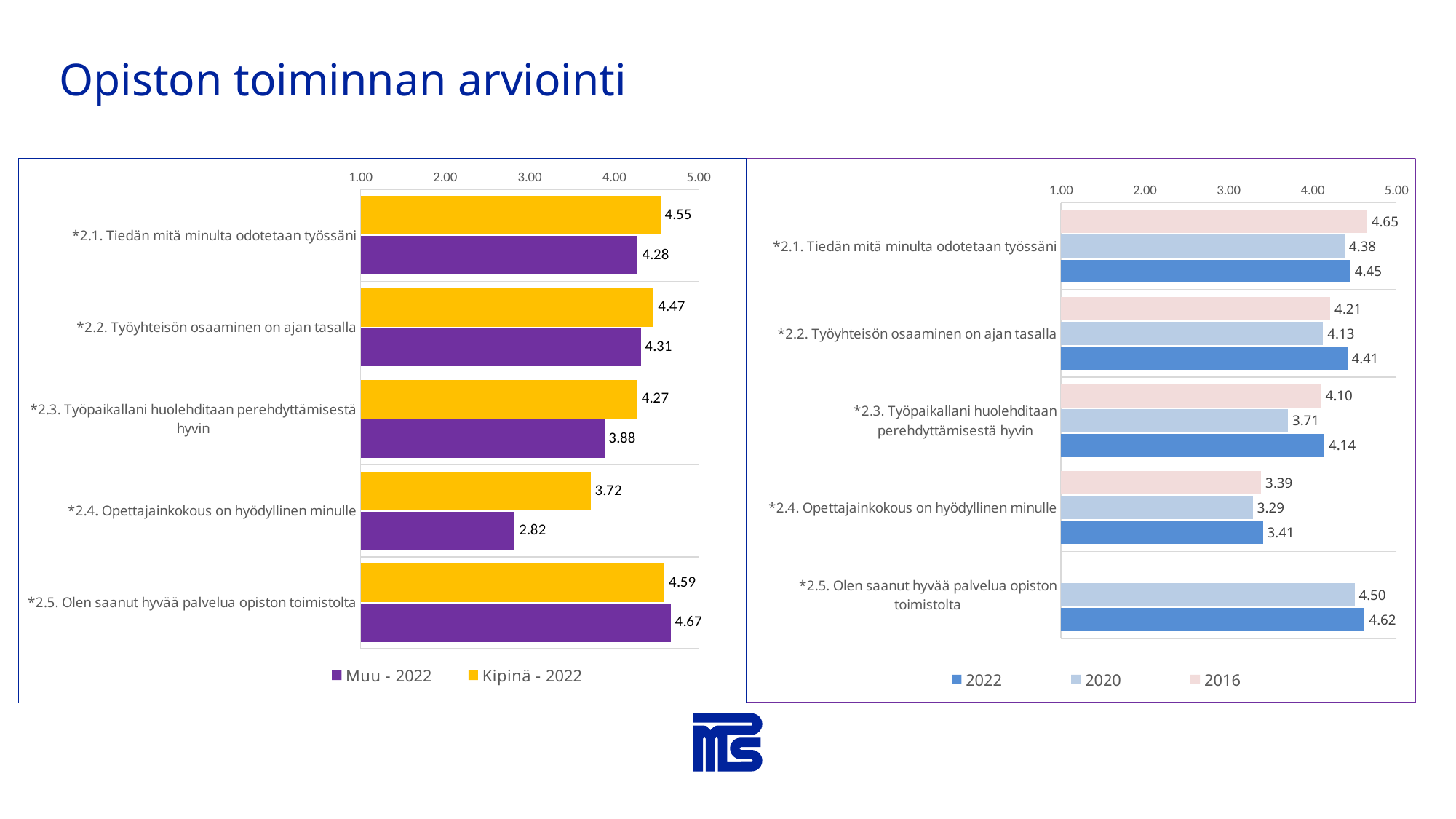
In the left chart, which category has the lowest value for Muu - 2022? *2.4. Opettajainkokous on hyödyllinen minulle In the right chart, which category has the highest 2022 value? *2.5. Olen saanut hyvää palvelua opiston toimistolta In the right chart, what is the difference between the 2022 and 2020 values for "*2.2. Työyhteisön osaaminen on ajan tasalla"? 0.28 In the left chart, what is the value for Muu - 2022 for "*2.5. Olen saanut hyvää palvelua opiston toimistolta"? 4.67 How many series does the legend of the left chart list? 2 What type of chart is the right chart? Bar chart In the left chart, what is the difference between the Kipinä - 2022 and Muu - 2022 values for "*2.4. Opettajainkokous on hyödyllinen minulle"? 0.90 How many series does the legend of the right chart list? 3 In the right chart, what is the 2020 value for "*2.3. Työpaikallani huolehditaan perehdyttämisestä hyvin"? 3.71 In the left chart, which is larger for "*2.5. Olen saanut hyvää palvelua opiston toimistolta": Muu - 2022 or Kipinä - 2022? Muu - 2022 In the left chart, what is the value for Kipinä - 2022 for "*2.4. Opettajainkokous on hyödyllinen minulle"? 3.72 In the right chart, what is the 2016 value for "*2.1. Tiedän mitä minulta odotetaan työssäni"? 4.65